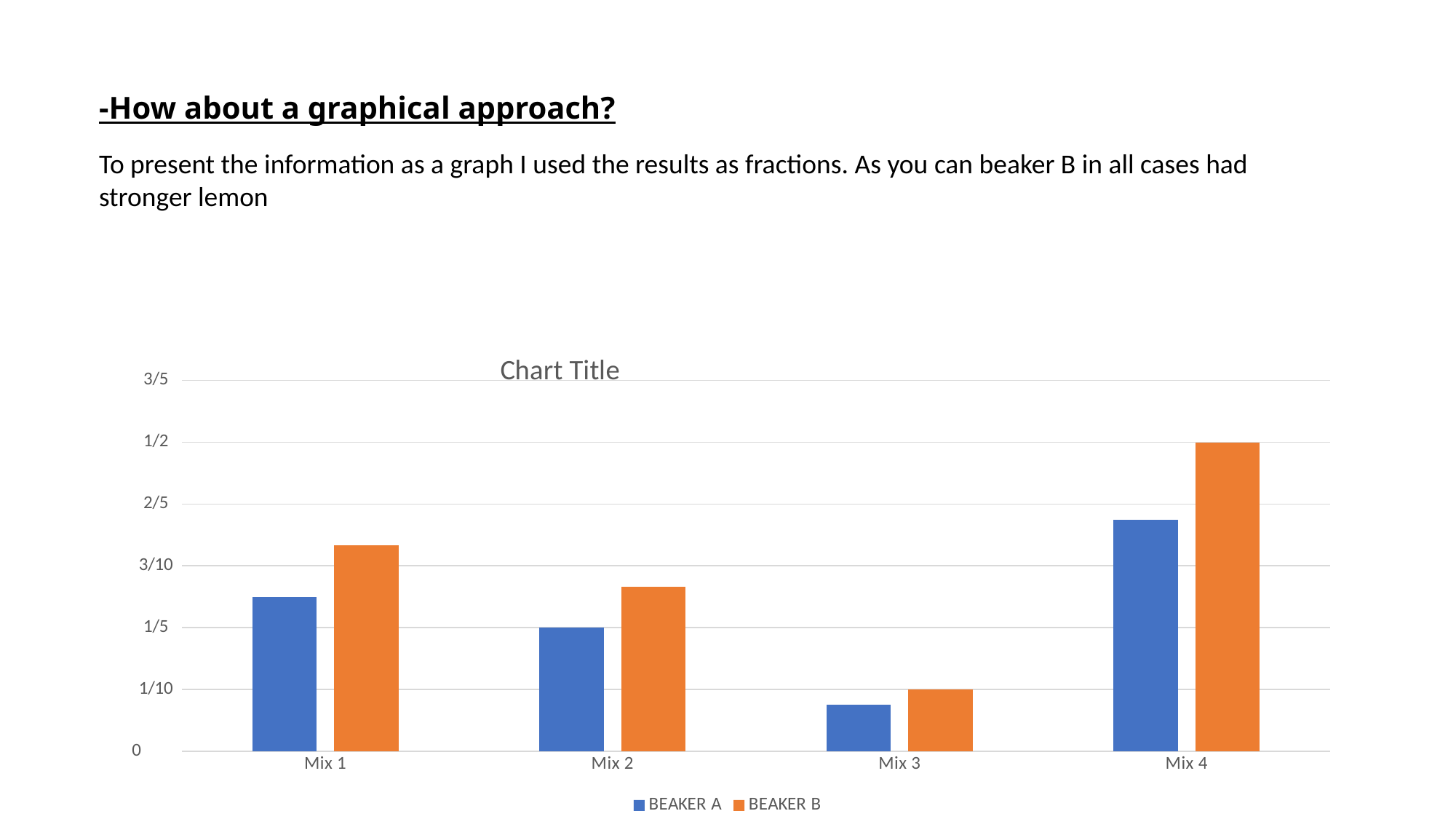
How many mixes (categories) are shown on the x axis? 4 At Mix 1, which is larger, BEAKER A or BEAKER B? BEAKER B What is the value for BEAKER A at Mix 2? 1/5 How many series does the legend list? 2 Is the value for BEAKER A at Mix 4 greater or less than 2/5? less What is the value for BEAKER B at Mix 3? 1/10 What kind of chart is shown on the slide? bar chart For which mix is the BEAKER B value highest? Mix 4 Is the value for BEAKER B at Mix 1 greater or less than 3/10? greater What is the value for BEAKER B at Mix 4? 1/2 For which mix is the BEAKER A value lowest? Mix 3 What are the two entries in the chart's legend? BEAKER A and BEAKER B